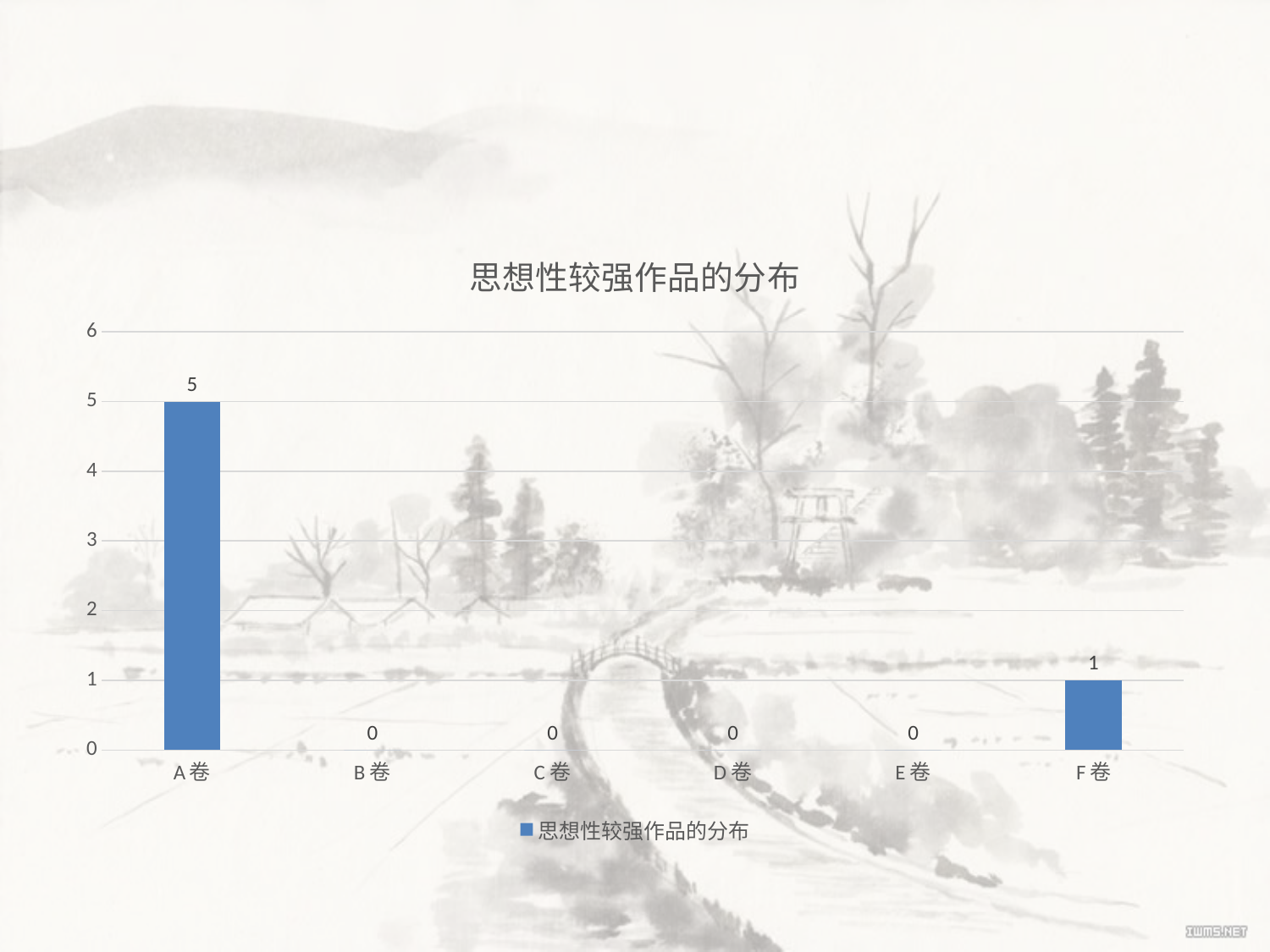
What is the value for F卷? 1 What is the value for C卷? 0 Which is larger, the value for A卷 or the value for F卷? A卷 How many categories are shown on the x axis? 6 Is the value for A卷 greater or less than 4? greater What is the value for A卷? 5 What is the title of the chart? 思想性较强作品的分布 What kind of chart is shown? bar chart Which category has the highest value? A卷 What is the difference between the values for A卷 and F卷? 4 How many series does the legend list? 1 How many categories have a value of 0? 4